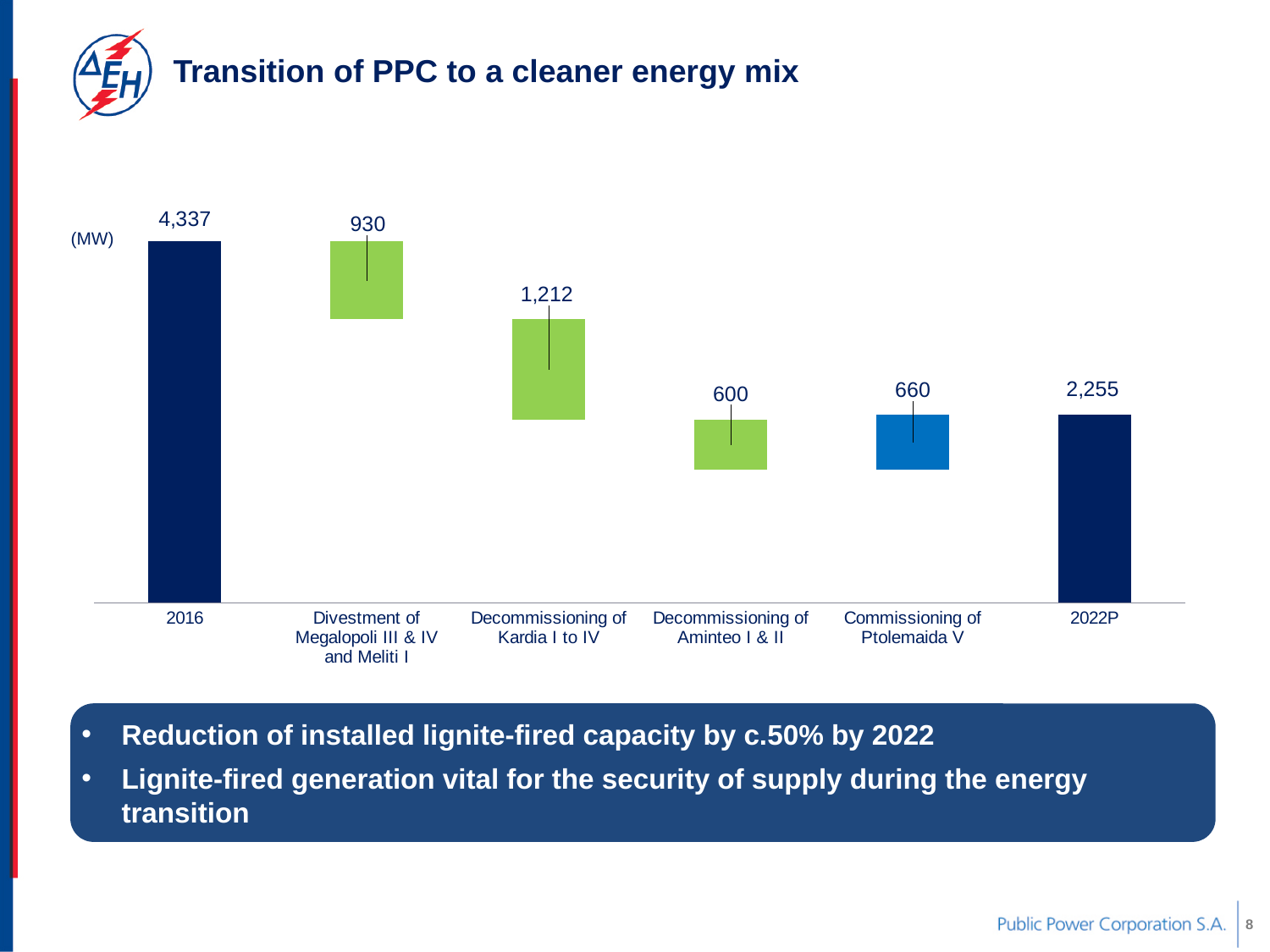
What value is shown for the Commissioning of Ptolemaida V? 660 What unit is indicated for the values on the chart? MW Which category has the lowest value on the chart? Decommissioning of Aminteo I & II How many categories are shown along the x axis of the chart? 6 What is the installed capacity value shown for 2016? 4,337 What is the value shown for 2022P? 2,255 What value is shown for the Divestment of Megalopoli III & IV and Meliti I? 930 Which is larger: the value for Decommissioning of Kardia I to IV or the value for Divestment of Megalopoli III & IV and Meliti I? Decommissioning of Kardia I to IV Which category has the highest value on the chart? 2016 What is the difference between the 2016 value and the 2022P value? 2,082 What value is shown for the Decommissioning of Kardia I to IV? 1,212 What kind of chart is shown on the slide? Bar chart (waterfall)